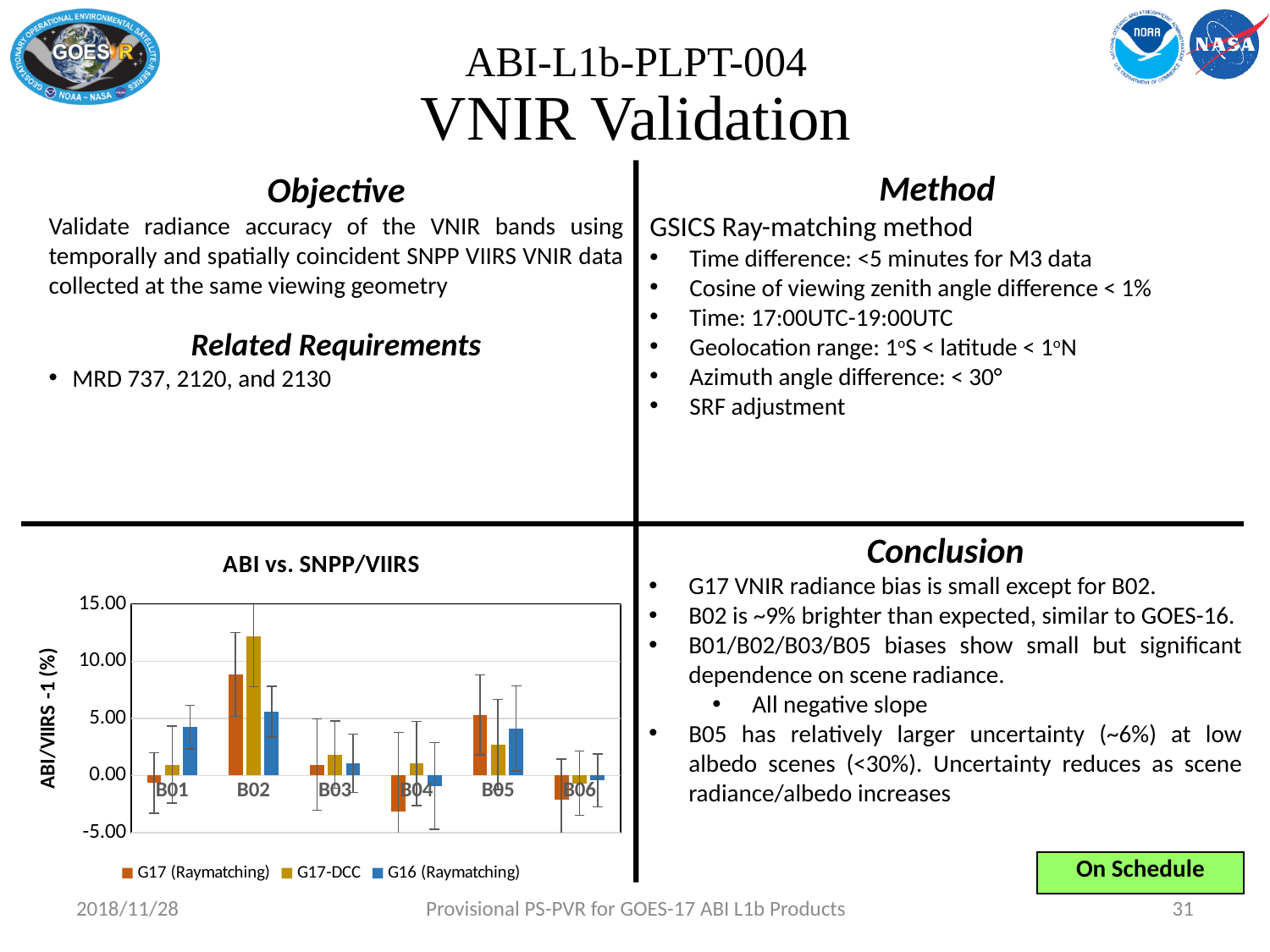
In the "ABI vs. SNPP/VIIRS" chart, is the G17 (Raymatching) value for B02 greater or less than 5.00? greater How many series does the legend of the "ABI vs. SNPP/VIIRS" chart list? 3 In the "ABI vs. SNPP/VIIRS" chart, is the G17-DCC value for B02 greater or less than 10.00? greater How many bands (categories) are shown on the x axis of the "ABI vs. SNPP/VIIRS" chart? 6 In the "ABI vs. SNPP/VIIRS" chart, which band has the lowest G17 (Raymatching) value? B04 What kind of chart is the "ABI vs. SNPP/VIIRS" chart? bar chart In the "ABI vs. SNPP/VIIRS" chart, is the G17 (Raymatching) value for B04 greater or less than 0.00? less What is the y-axis label of the "ABI vs. SNPP/VIIRS" chart? ABI/VIIRS -1 (%) In the "ABI vs. SNPP/VIIRS" chart, which band has the highest G17 (Raymatching) value? B02 In the "ABI vs. SNPP/VIIRS" chart, for B05, which is larger: the G17 (Raymatching) value or the G17-DCC value? G17 (Raymatching) In the "ABI vs. SNPP/VIIRS" chart, which band has the highest G17-DCC value? B02 In the "ABI vs. SNPP/VIIRS" chart, for B02, which is larger: the G17-DCC value or the G17 (Raymatching) value? G17-DCC